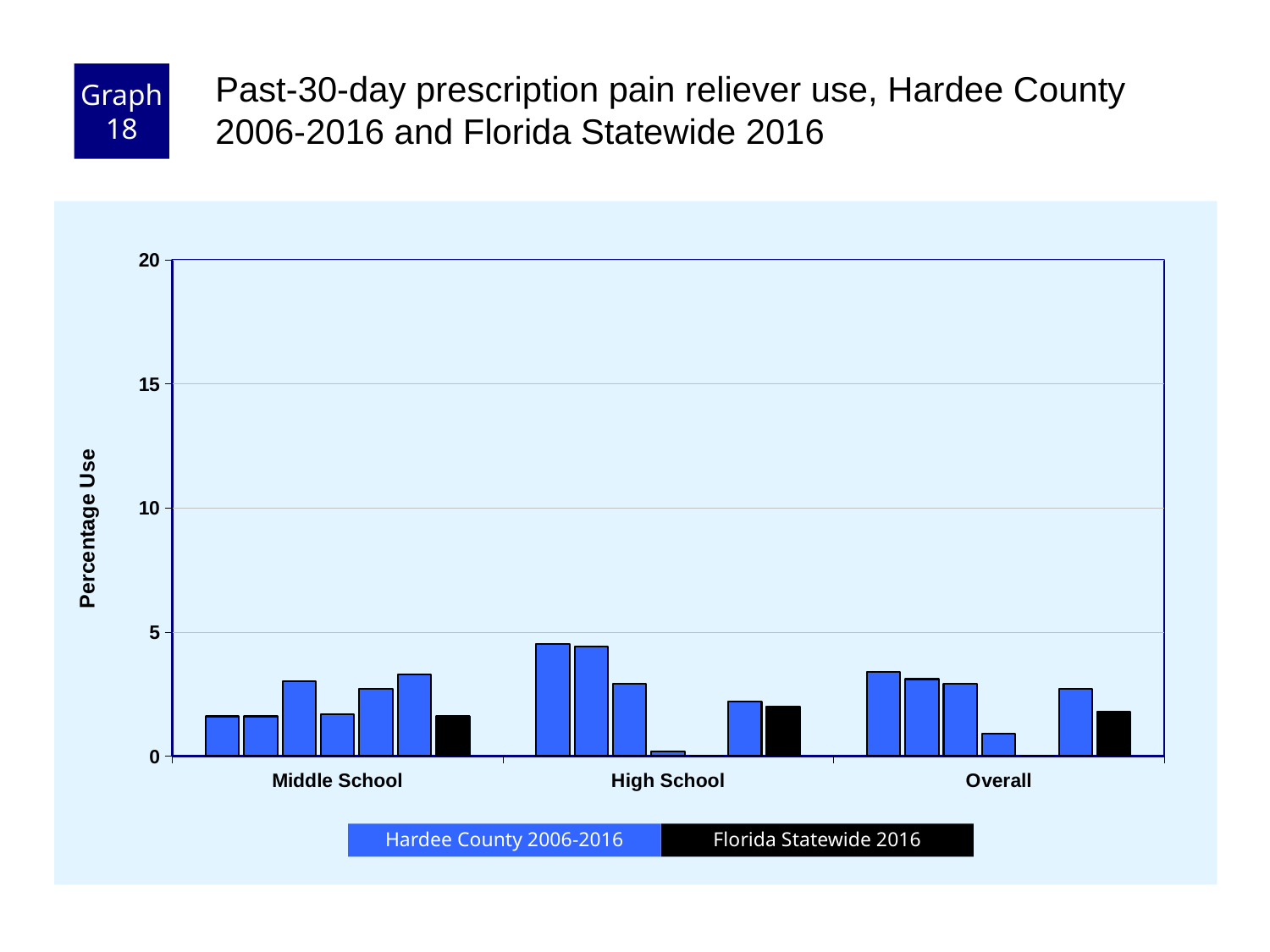
Is the Florida Statewide 2016 value for Overall greater or less than 5? less How many series does the legend list? 2 What is the label of the y axis? Percentage Use Is the value for Florida Statewide 2016 in the High School category greater or less than 5? less Is the tallest Hardee County bar in the High School category greater or less than 5? less What kind of chart is shown on the slide? bar chart Which series is shown in black in the legend? Florida Statewide 2016 How many categories are shown along the x axis? 3 Which is larger: the Florida Statewide 2016 bar for High School or the Florida Statewide 2016 bar for Middle School? High School Which is larger: the tallest Hardee County bar in High School or the tallest Hardee County bar in Middle School? High School Which category contains the tallest bar on the chart? High School